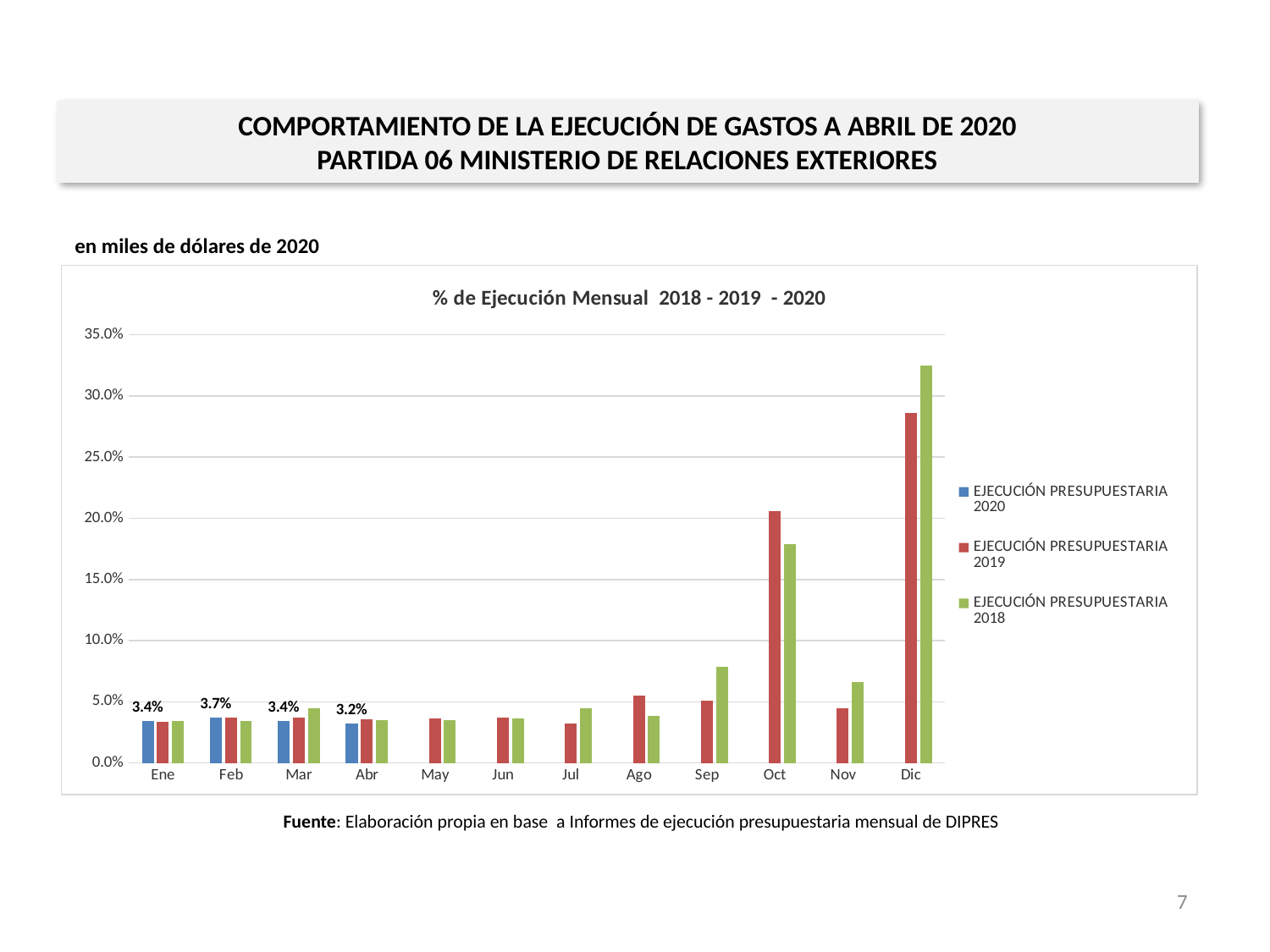
What is the difference between the EJECUCIÓN PRESUPUESTARIA 2020 values for Feb and Abr? 0.5% Is the value for EJECUCIÓN PRESUPUESTARIA 2018 in Oct greater or less than 20.0%? less What is the value for EJECUCIÓN PRESUPUESTARIA 2020 in Feb? 3.7% How many months are shown on the x axis? 12 What is the value for EJECUCIÓN PRESUPUESTARIA 2020 in Abr? 3.2% Which month has the highest value for EJECUCIÓN PRESUPUESTARIA 2020? Feb What kind of chart is shown on the slide? Bar chart Which month has the lowest value for EJECUCIÓN PRESUPUESTARIA 2020? Abr What is the value for EJECUCIÓN PRESUPUESTARIA 2020 in Ene? 3.4% Is the value for EJECUCIÓN PRESUPUESTARIA 2018 in Dic greater or less than 30.0%? greater How many series does the legend list? 3 In Dic, which series has the larger value: EJECUCIÓN PRESUPUESTARIA 2018 or EJECUCIÓN PRESUPUESTARIA 2019? EJECUCIÓN PRESUPUESTARIA 2018